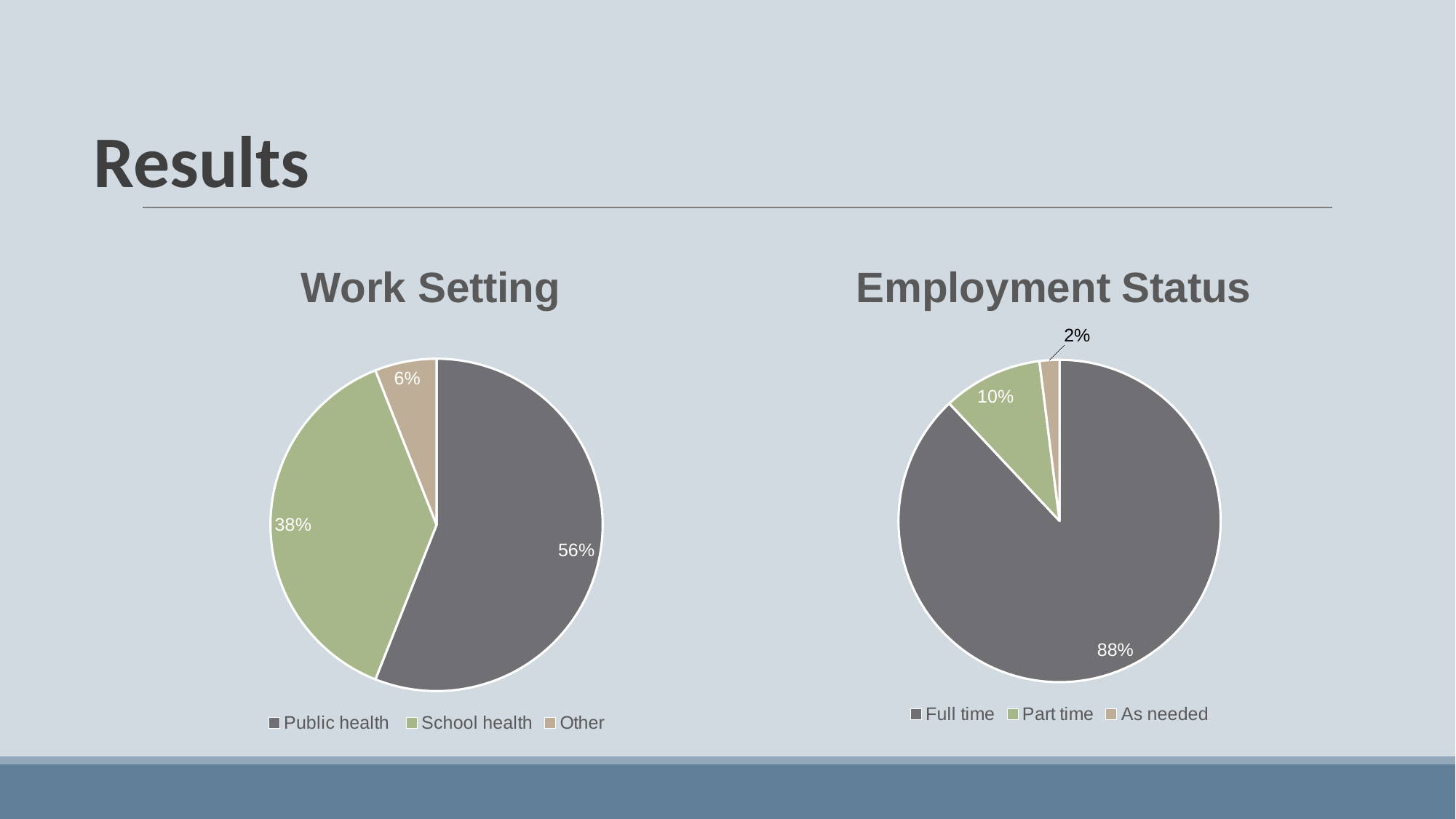
In the Work Setting chart, what is the difference between the Public health and School health shares? 18% In the Work Setting chart, what share of the pie is School health? 38% How many categories does the Employment Status chart show? 3 In the Employment Status chart, what is the value for Part time? 10% What kind of chart is the Work Setting chart? Pie chart In the Work Setting chart, which category has the largest slice? Public health In the Work Setting chart, what share of the pie is Public health? 56% In the Work Setting chart, which category has the smallest slice? Other In the Work Setting chart, what is the value for Other? 6% In the Employment Status chart, which is larger, Part time or As needed? Part time In the Employment Status chart, what is the value for As needed? 2% In the Employment Status chart, what share of the pie is Full time? 88%